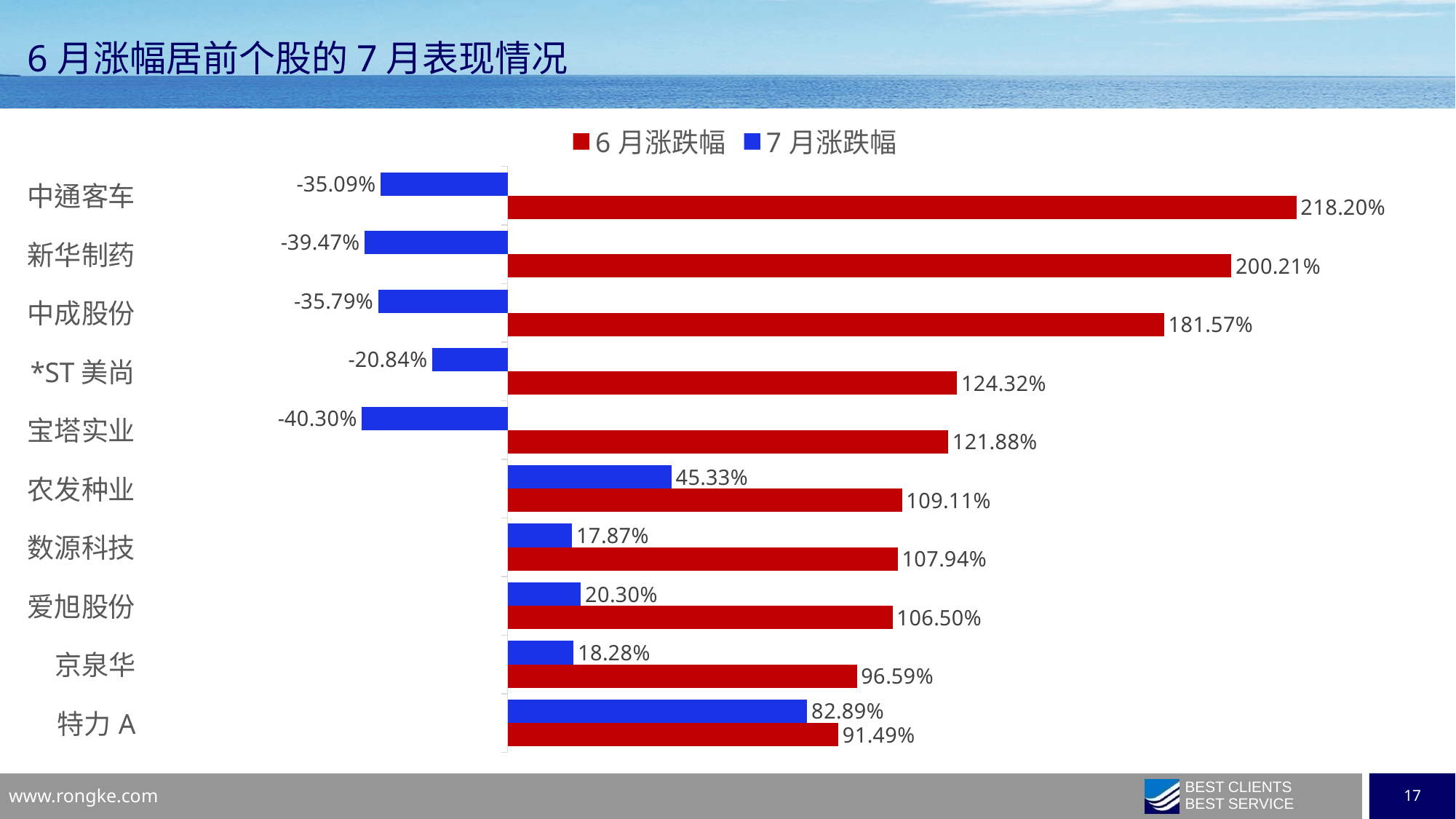
Which is larger, the 7月涨跌幅 of 数源科技 or of 爱旭股份? 爱旭股份 What type of chart is shown on the slide? Bar chart What is the difference between the 6月涨跌幅 and 7月涨跌幅 for 特力A? 8.60% What is the 7月涨跌幅 value for 农发种业? 45.33% What is the 6月涨跌幅 value for 中通客车? 218.20% Which stock has the highest 6月涨跌幅? 中通客车 Which stock has the lowest 7月涨跌幅? 宝塔实业 What is the 7月涨跌幅 value for 宝塔实业? -40.30% How many series does the legend list? 2 What is the difference between the 6月涨跌幅 of 中通客车 and 新华制药? 17.99% Which stock has the highest 7月涨跌幅? 特力A How many stocks are shown in the chart? 10